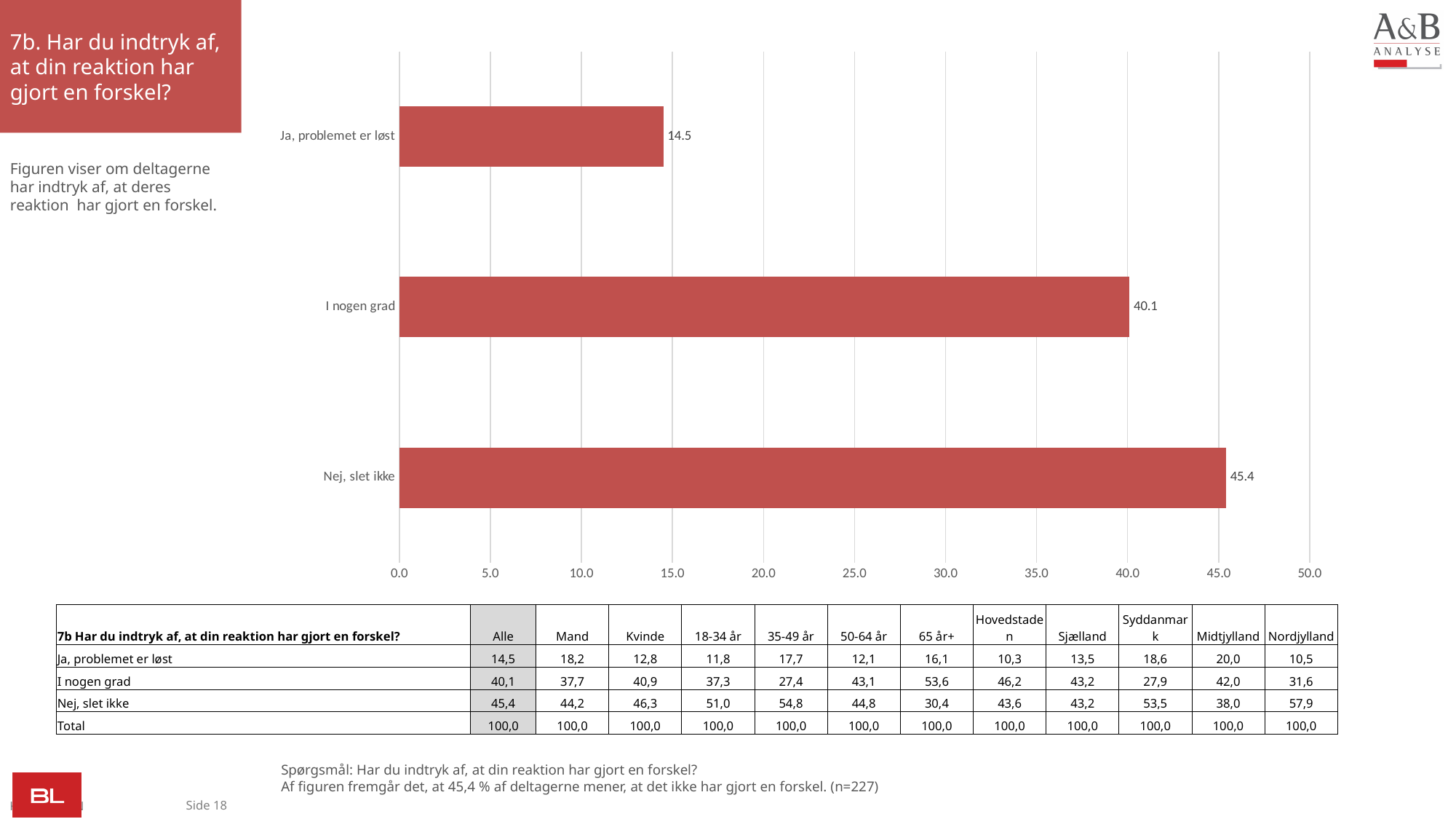
Which category has the highest value in the chart? Nej, slet ikke What is the value for "I nogen grad" in the chart? 40.1 Is the value for "I nogen grad" greater or less than 35.0? greater What is the difference between the values for "Nej, slet ikke" and "Ja, problemet er løst"? 30.9 Which category has the lowest value in the chart? Ja, problemet er løst What is the value for "Nej, slet ikke" in the chart? 45.4 What is the difference between the values for "Nej, slet ikke" and "I nogen grad"? 5.3 Which is larger, the value for "I nogen grad" or the value for "Ja, problemet er løst"? I nogen grad What kind of chart is shown on the slide? Bar chart How many categories are shown in the chart? 3 What is the highest value shown on the chart's horizontal axis? 50.0 What is the value for "Ja, problemet er løst" in the chart? 14.5